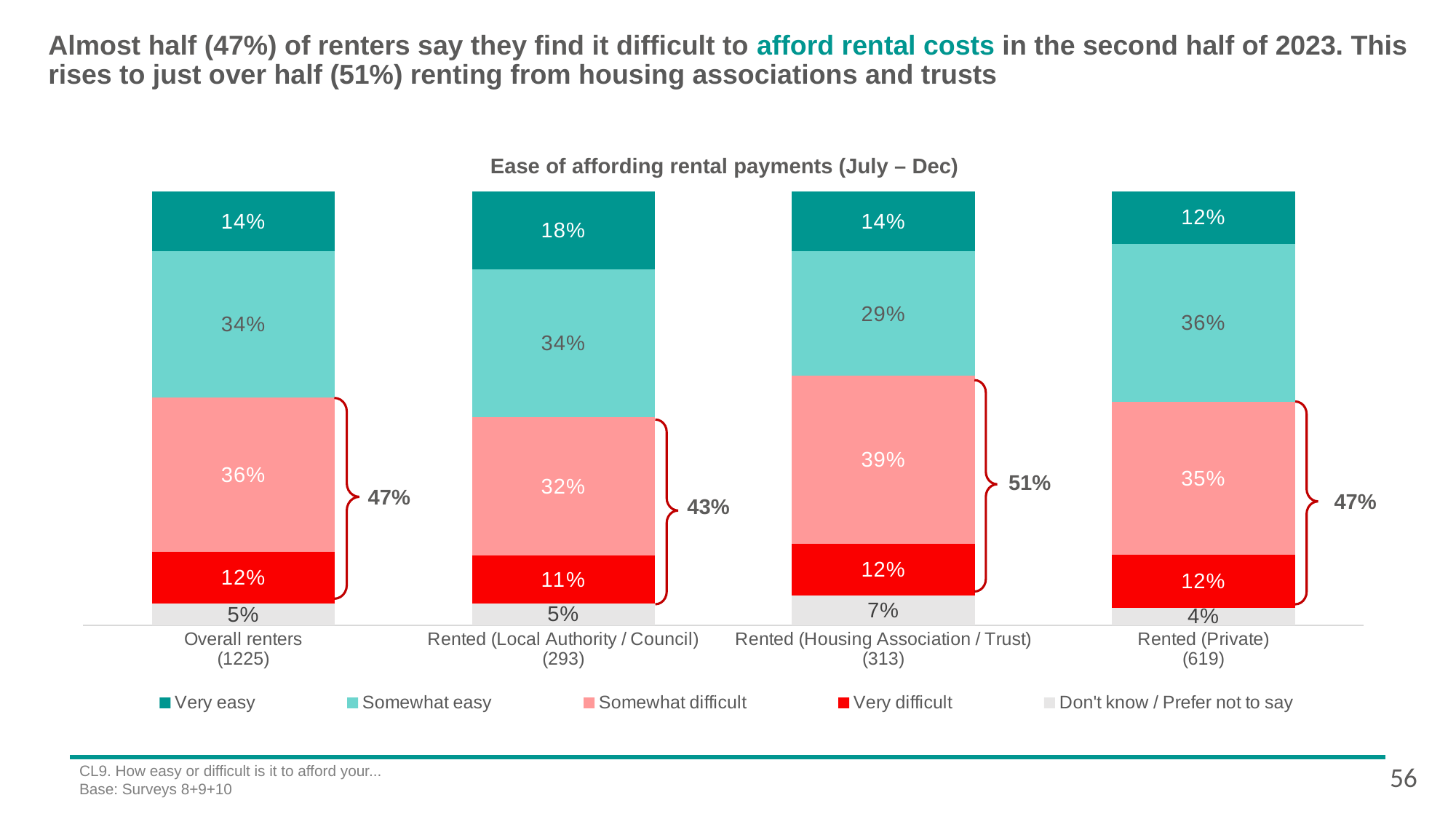
What is the difference between the Somewhat easy percentages for Rented (Private) and Rented (Housing Association / Trust)? 7% What kind of chart is shown on the slide? Stacked bar chart What percentage of Rented (Housing Association / Trust) respondents answered Don't know / Prefer not to say? 7% What percentage of Rented (Private) respondents say it is Somewhat easy? 36% How many categories are shown on the x axis? 4 What percentage of Overall renters say it is Somewhat difficult to afford rental payments? 36% Is the Very difficult percentage larger for Rented (Housing Association / Trust) or Rented (Local Authority / Council)? Rented (Housing Association / Trust) Which category has the highest Somewhat difficult percentage? Rented (Housing Association / Trust) How many series does the legend list? 5 What percentage of Rented (Local Authority / Council) respondents say it is Very easy? 18% Which category has the lowest Very easy percentage? Rented (Private) What is the combined percentage of Somewhat difficult and Very difficult for Rented (Local Authority / Council)? 43%